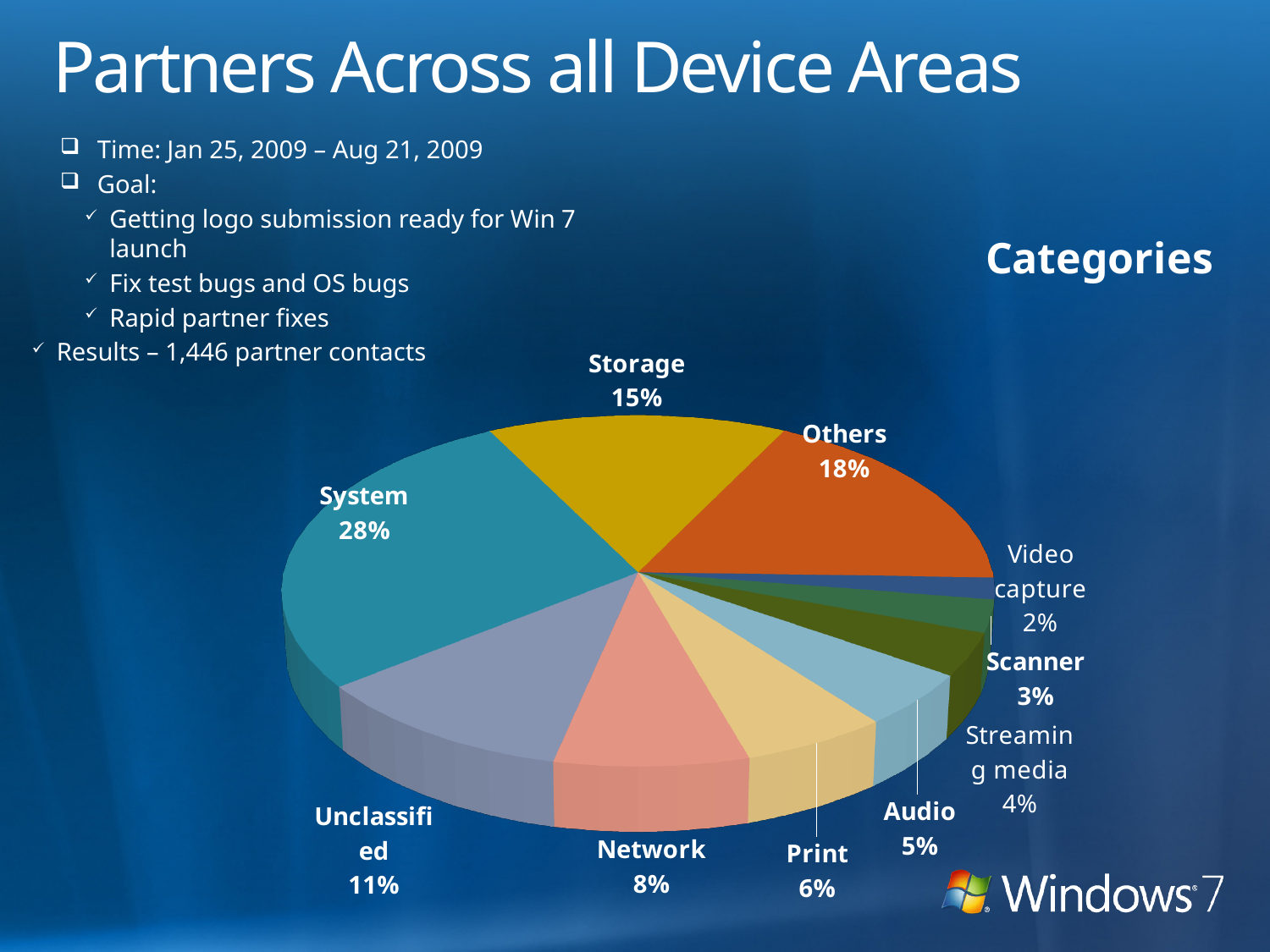
Which is larger, the share for Network or the share for Print? Network How many categories are shown in the pie chart? 10 What kind of chart is shown on the slide? Pie chart What percentage is shown for Unclassified? 11% What share of the pie does System account for? 28% What is the difference in percentage points between Others and Storage? 3 What percentage is shown for Storage? 15% What percentage is shown for Video capture? 2% Which category has the smallest slice of the pie? Video capture What is the title of the chart? Categories Which category has the largest slice of the pie? System What is the combined share of Audio and Scanner? 8%